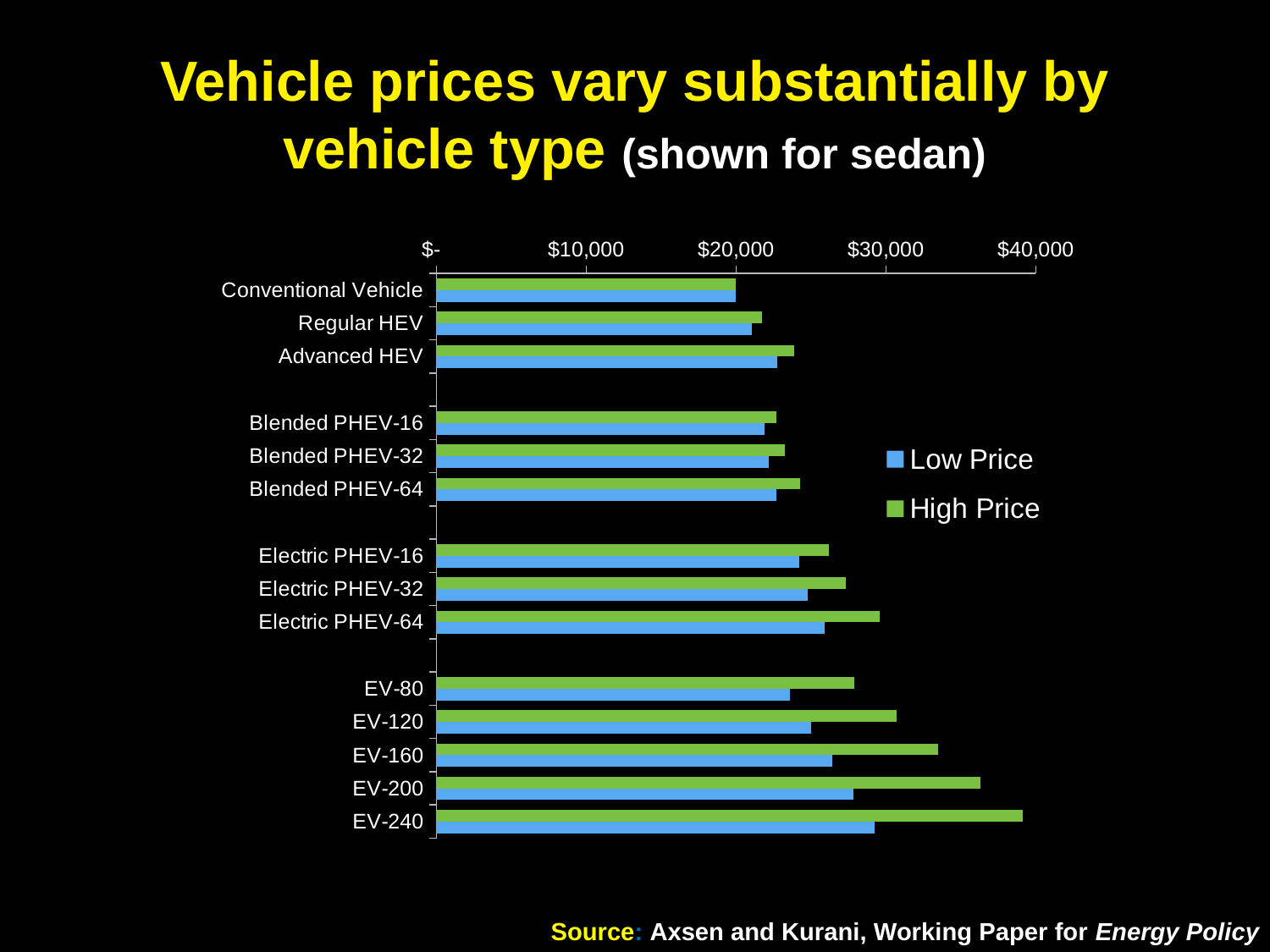
Is the High Price for EV-200 greater or less than $30,000? greater How many vehicle types are plotted on the chart? 14 Is the Low Price for Electric PHEV-16 greater or less than $20,000? greater Is the High Price for EV-240 greater or less than $30,000? greater What kind of chart is shown on the slide? bar chart Which vehicle type has the highest Low Price? EV-240 How many series does the legend list? 2 Which has the larger High Price, Electric PHEV-64 or Blended PHEV-64? Electric PHEV-64 Which vehicle type has the lowest High Price? Conventional Vehicle Do the High Price values rise or fall going from EV-80 to EV-240? rise Which vehicle type has the highest High Price? EV-240